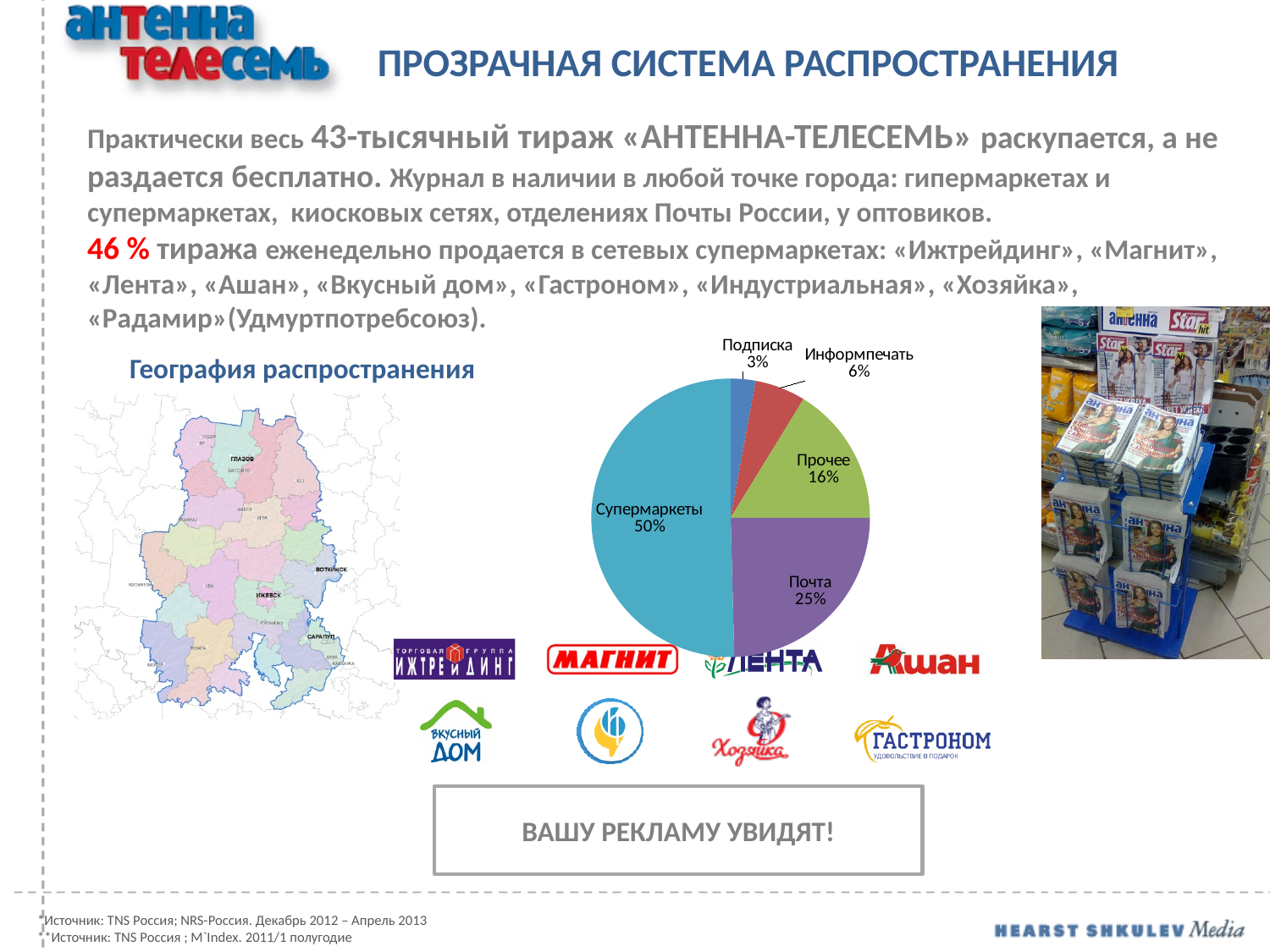
What share of the pie chart does Супермаркеты have? 50% What share of the pie chart does Почта have? 25% Which slice of the pie chart is the smallest? Подписка What share of the pie chart does Прочее have? 16% What is the difference between the shares of Почта and Прочее in the pie chart? 9% What is the difference between the shares of Супермаркеты and Почта in the pie chart? 25% What kind of chart is shown on the slide? pie chart What share of the pie chart does Подписка have? 3% How many slices does the pie chart have? 5 Which is larger in the pie chart, Прочее or Информпечать? Прочее Which slice of the pie chart is the largest? Супермаркеты What share of the pie chart does Информпечать have? 6%